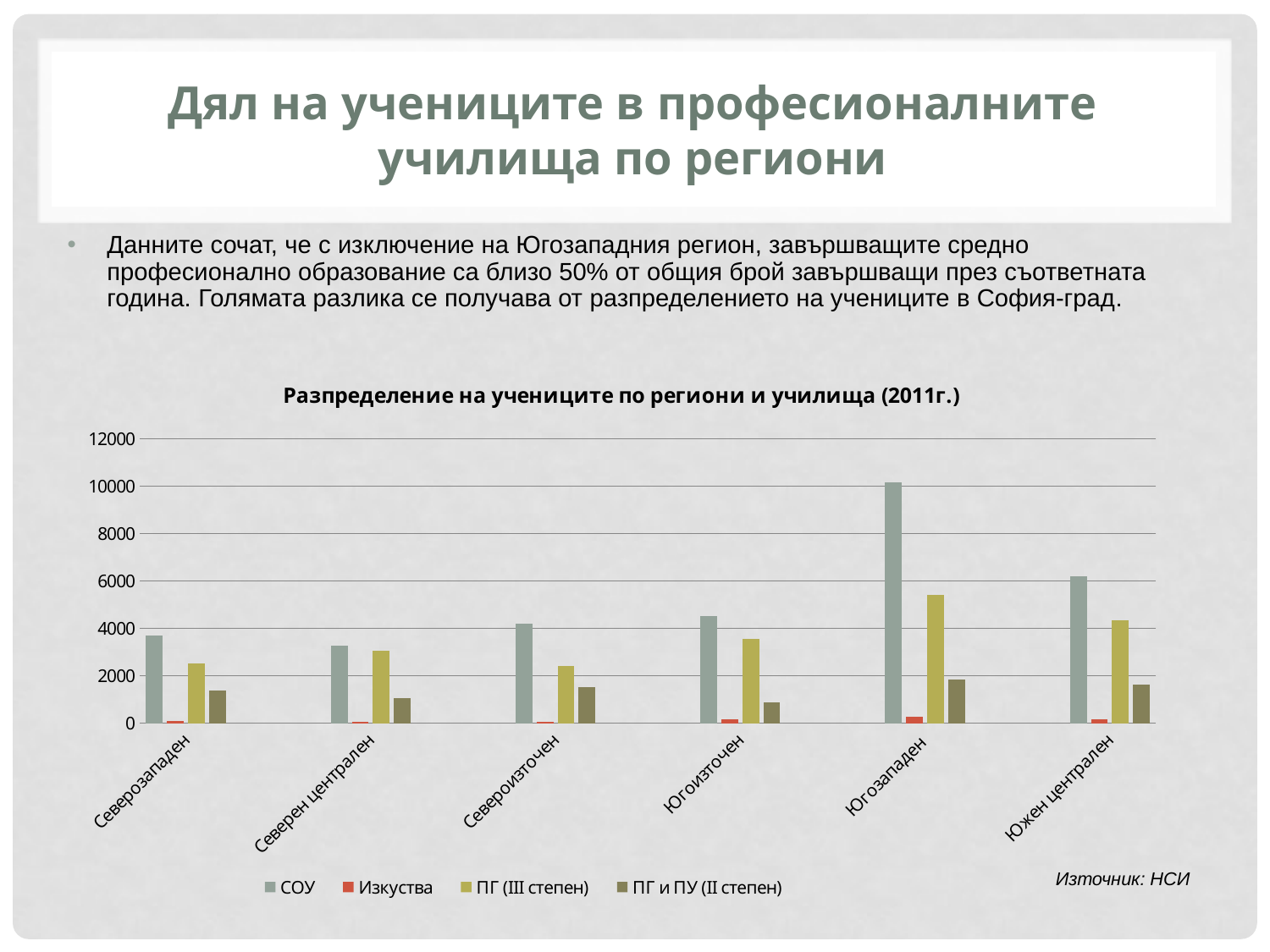
Which region has the highest value for ПГ (III степен)? Югозападен Is the value for СОУ in Югозападен greater or less than 8000? greater Which region has the highest value for СОУ? Югозападен What kind of chart is shown on the slide? bar chart In Югоизточен, which is larger: СОУ or ПГ (III степен)? СОУ Is the value for СОУ in Южен централен greater or less than 4000? greater Is the value for ПГ и ПУ (II степен) in Северозападен greater or less than 2000? less How many regions are shown on the x axis of the chart? 6 What is the title of the chart? Разпределение на учениците по региони и училища (2011г.) Which colour represents the Изкуства series in the chart? red How many series does the chart legend list? 4